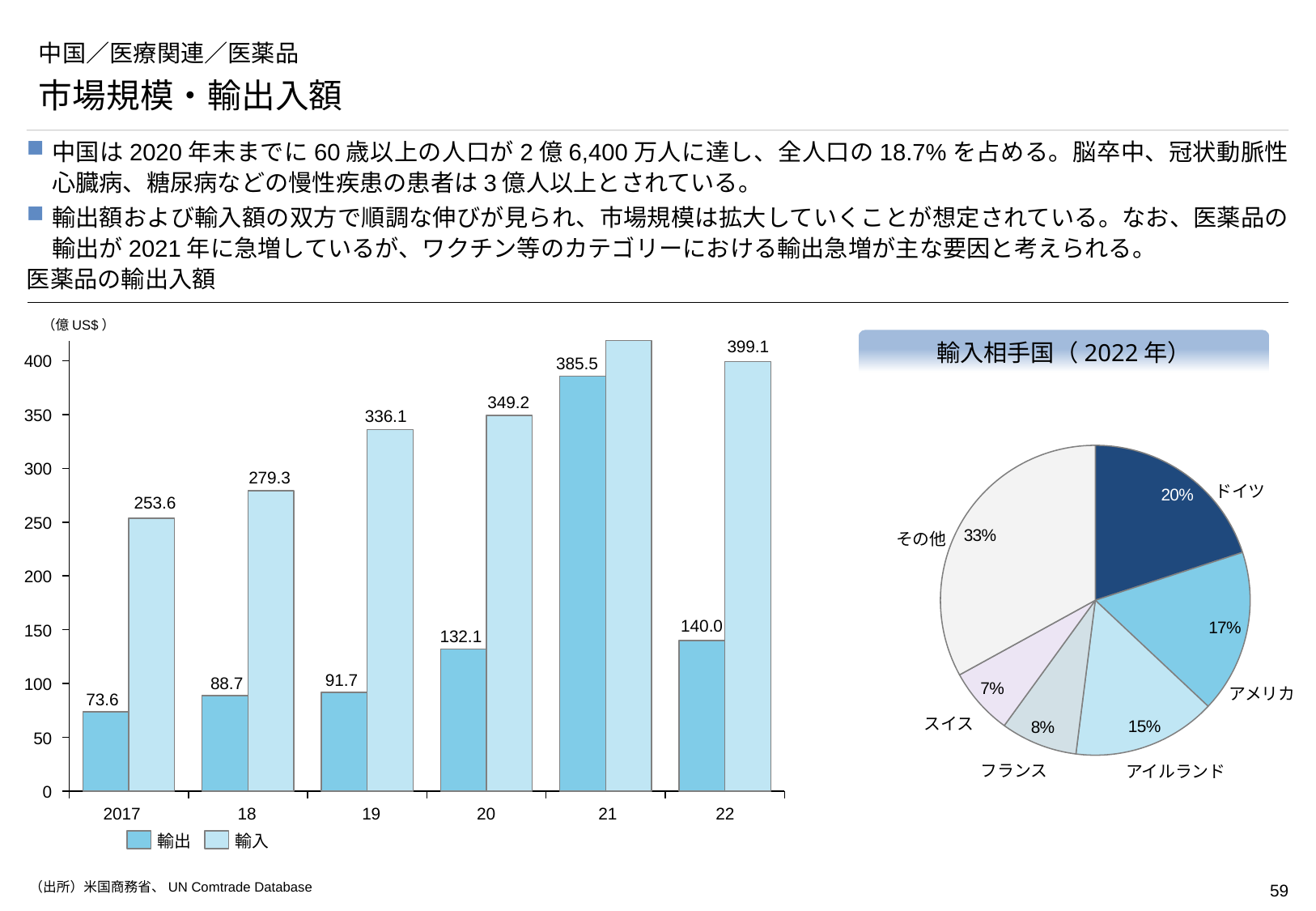
What kind of chart is 輸入相手国（2022年）? pie chart In the bar chart 医薬品の輸出入額, which year has the highest 輸出 value? 21 In the pie chart 輸入相手国（2022年）, what share does ドイツ have? 20% In the pie chart 輸入相手国（2022年）, how many slices are there? 6 In the bar chart 医薬品の輸出入額, which year has the lowest 輸入 value? 2017 In the bar chart 医薬品の輸出入額, what is the 輸出 value for 2017? 73.6 In the bar chart 医薬品の輸出入額, what is the difference between the 輸入 and 輸出 values for 20? 217.1 In the bar chart 医薬品の輸出入額, how many series does the legend list? 2 In the bar chart 医薬品の輸出入額, do the 輸入 values rise or fall from 2017 to 20? rise In the bar chart 医薬品の輸出入額, what is the 輸入 value for 22? 399.1 In the bar chart 医薬品の輸出入額, which is larger, the 輸出 value for 22 or the 輸出 value for 20? 輸出 for 22 In the bar chart 医薬品の輸出入額, is the 輸入 value for 21 greater or less than 400? greater